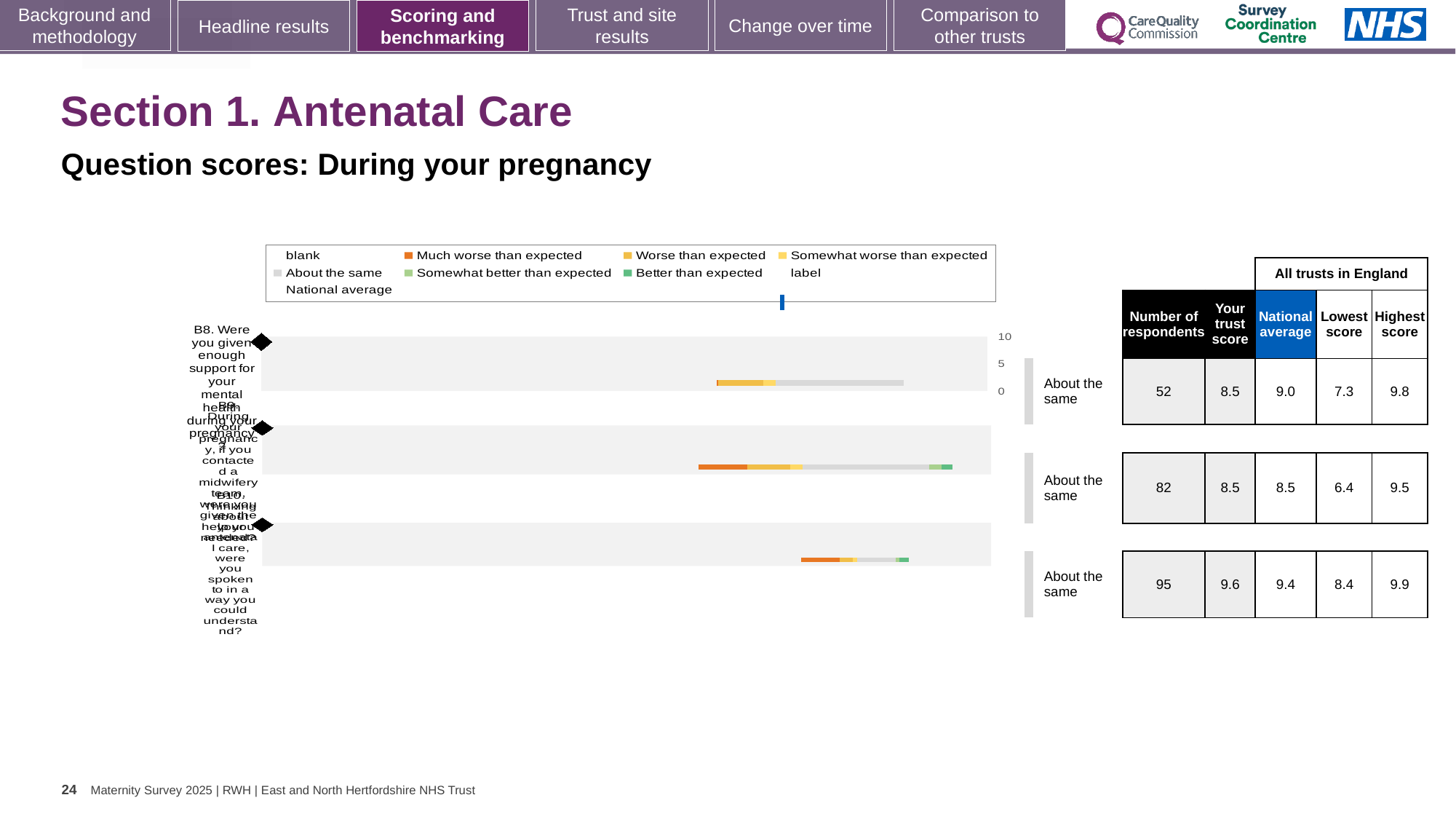
What colour in the legend represents 'Much worse than expected'? orange What is the number of respondents for the first question row (B8, support for your mental health during pregnancy)? 52 What kind of chart is shown on the slide? bar chart What is the lowest score among all trusts in England for the second question row? 6.4 What is the difference between the trust score and the national average for the third question row? 0.2 What is the national average for the first question row (B8)? 9.0 Is the trust score for the third question row larger or smaller than its national average? larger How many question rows (bars) are plotted in the chart? 3 What is the trust score for the first question row (B8)? 8.5 What benchmark category is shown for all three question rows? About the same Which question row has the highest number of respondents? the third row (95 respondents) What is the highest score among all trusts in England for the third question row? 9.9